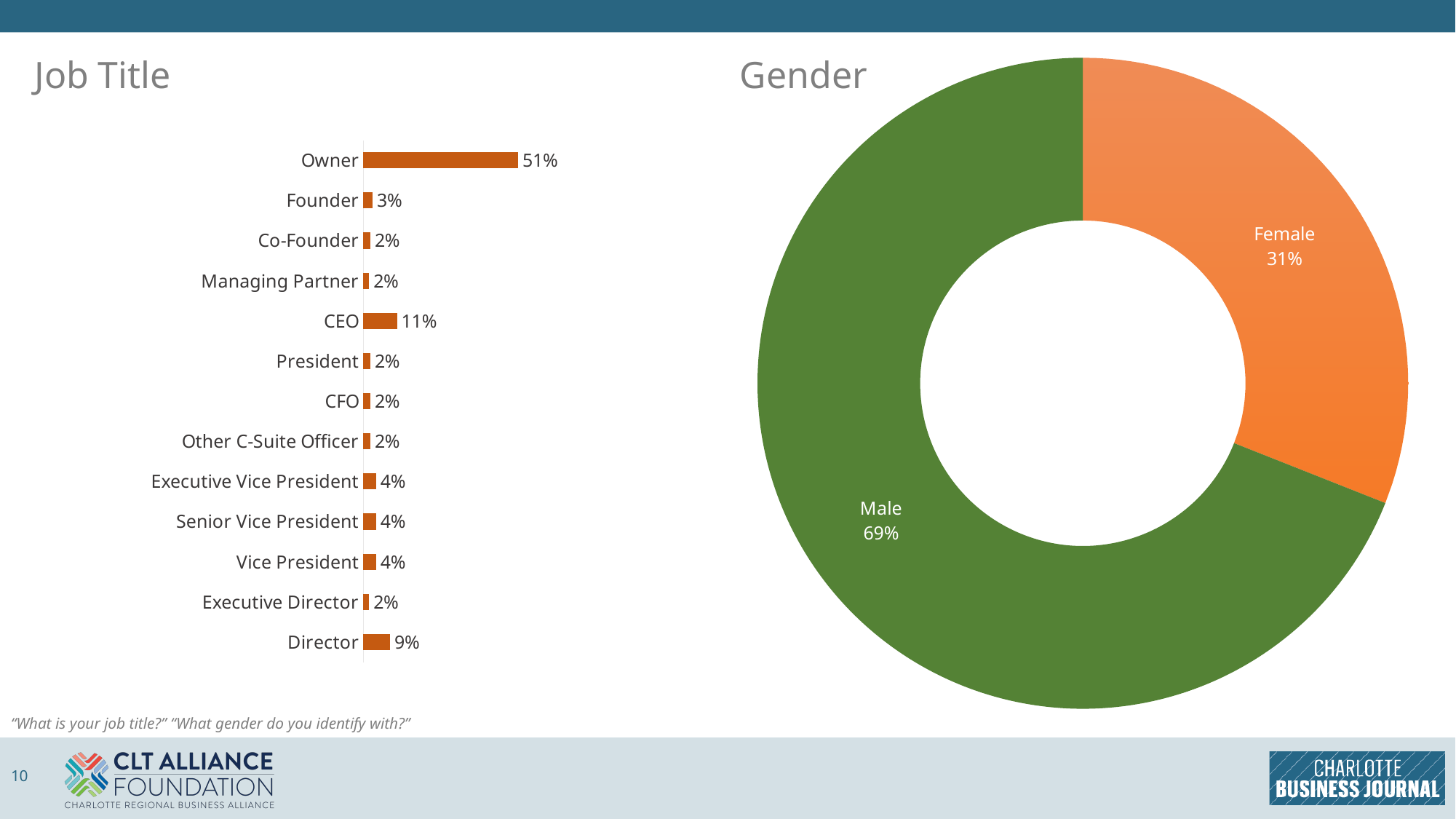
What kind of chart is the Job Title chart? Bar chart In the Job Title chart, which is larger, the value for CEO or the value for Director? CEO In the Gender chart, what is the value for Female? 31% In the Job Title chart, which job title has the highest value? Owner What kind of chart is the Gender chart? Doughnut chart In the Gender chart, what is the value for Male? 69% In the Gender chart, what is the difference between the Male and Female shares? 38% In the Job Title chart, what is the value for CEO? 11% In the Job Title chart, what is the value for Owner? 51% In the Job Title chart, what is the difference between the values for Owner and CEO? 40% In the Job Title chart, what is the value for Director? 9% In the Job Title chart, how many job title categories are shown? 13